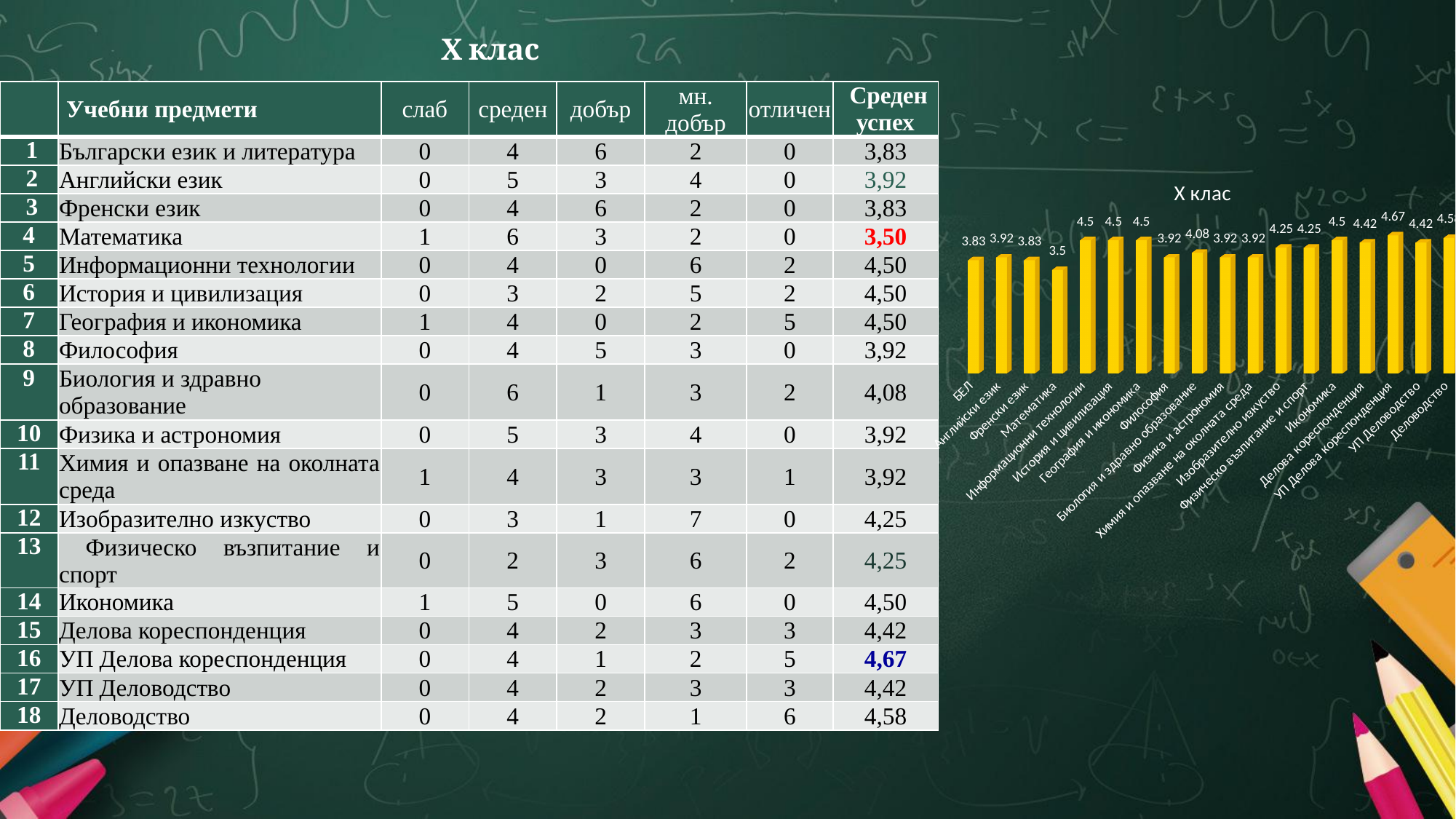
In the chart, what is the difference between the values for Делова кореспонденция and БЕЛ? 0.59 In the chart, which category has the highest value? УП Делова кореспонденция In the chart, what is the value for Математика? 3.5 In the chart, what is the value for Биология и здравно образование? 4.08 How many bars does the chart contain? 18 What is the title of the chart on the right side of the slide? Х клас In the chart, what is the value for Философия? 3.92 What kind of chart is shown on the right side of the slide? bar chart In the chart, which category has the lowest value? Математика In the chart, what is the difference between the values for УП Делова кореспонденция and Математика? 1.17 In the chart, what is the value for УП Делова кореспонденция? 4.67 In the chart, which is larger: the value for Икономика or the value for Изобразително изкуство? Икономика